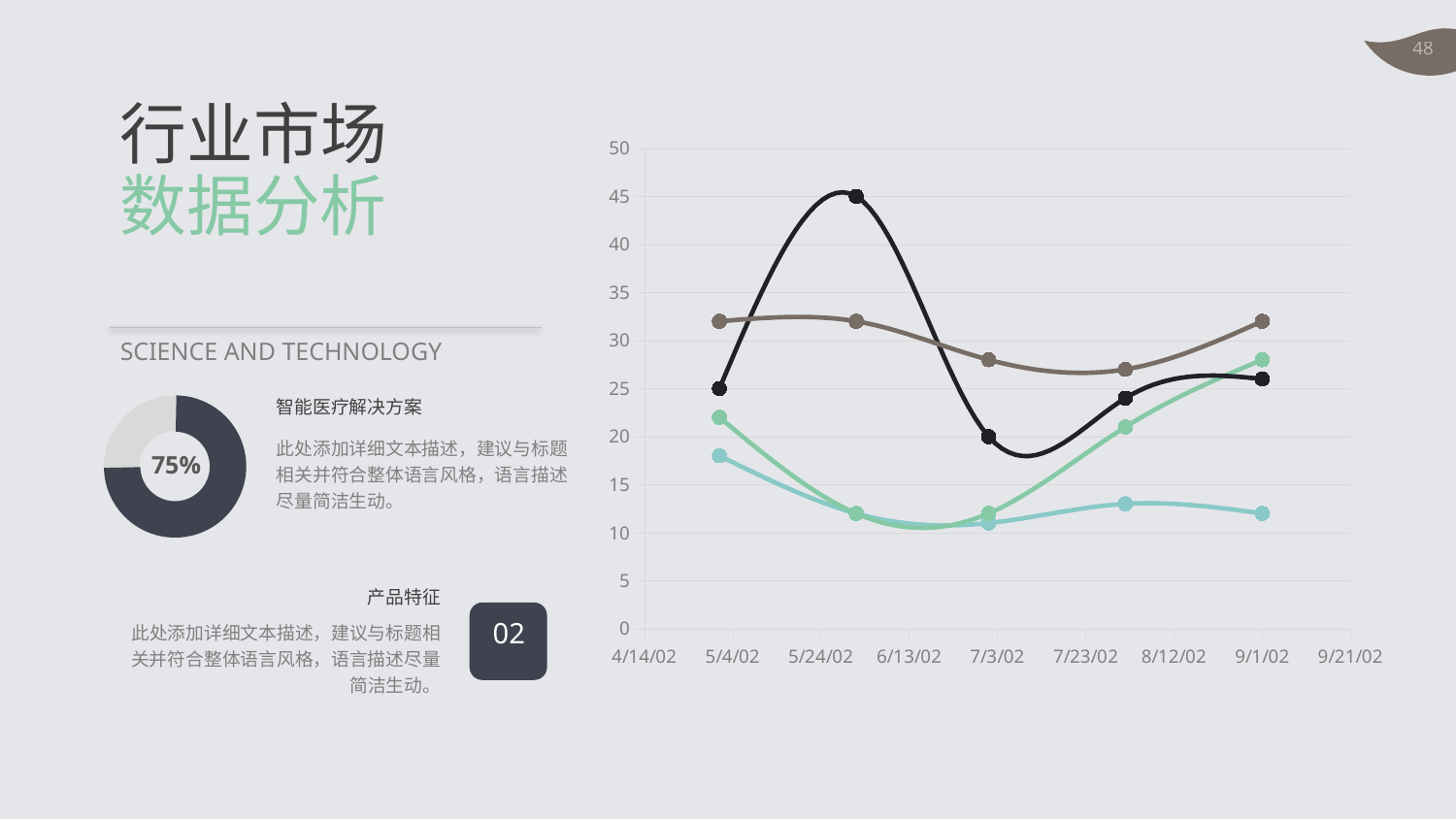
On the line chart, which line has the lowest value at 9/1/02? the teal line On the line chart, is the value of the brown line at 9/1/02 greater or less than 30? greater How many lines are plotted on the line chart? 4 On the line chart, which line reaches the highest value? the black line On the line chart, is the value of the teal line at 9/1/02 greater or less than 15? less What percentage is shown in the centre of the donut chart on the left of the slide? 75% What kind of chart is the large chart on the right of the slide? line chart On the line chart, does the teal line end higher or lower than it starts? lower On the line chart, is the peak of the black line greater or less than 40? greater On the line chart, what is the peak value of the black line? 45 On the line chart, which is larger at 9/1/02: the brown line or the teal line? the brown line What is the highest value shown on the y axis of the line chart? 50